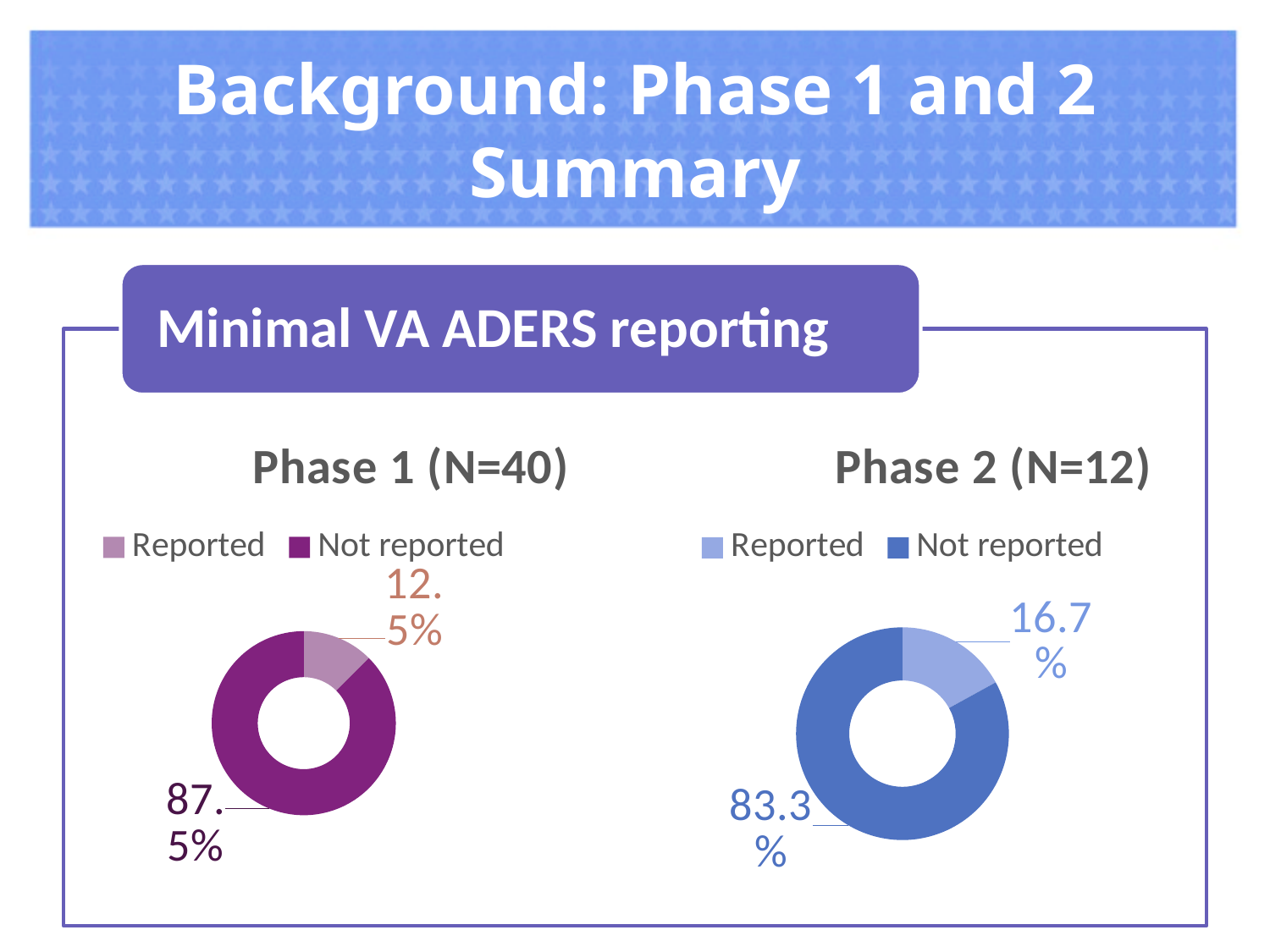
What kind of chart is the Phase 1 (N=40) chart? Doughnut chart Which chart has the larger Reported share, Phase 1 (N=40) or Phase 2 (N=12)? Phase 2 (N=12) In the Phase 2 (N=12) chart, what percentage is labelled for Reported? 16.7% In the Phase 1 (N=40) chart, what percentage is labelled for Not reported? 87.5% How many categories does the Phase 2 (N=12) chart show? 2 In the Phase 1 (N=40) chart, what percentage is labelled for Reported? 12.5% In the Phase 2 (N=12) chart, what is the difference between the Not reported and Reported percentages? 66.6% In the Phase 1 (N=40) chart, which category has the largest share? Not reported In the Phase 2 (N=12) chart, what percentage is labelled for Not reported? 83.3% What are the two legend entries in the Phase 1 (N=40) chart? Reported, Not reported In the Phase 1 (N=40) chart, what is the difference between the Not reported and Reported percentages? 75% In the Phase 2 (N=12) chart, which category has the smallest share? Reported